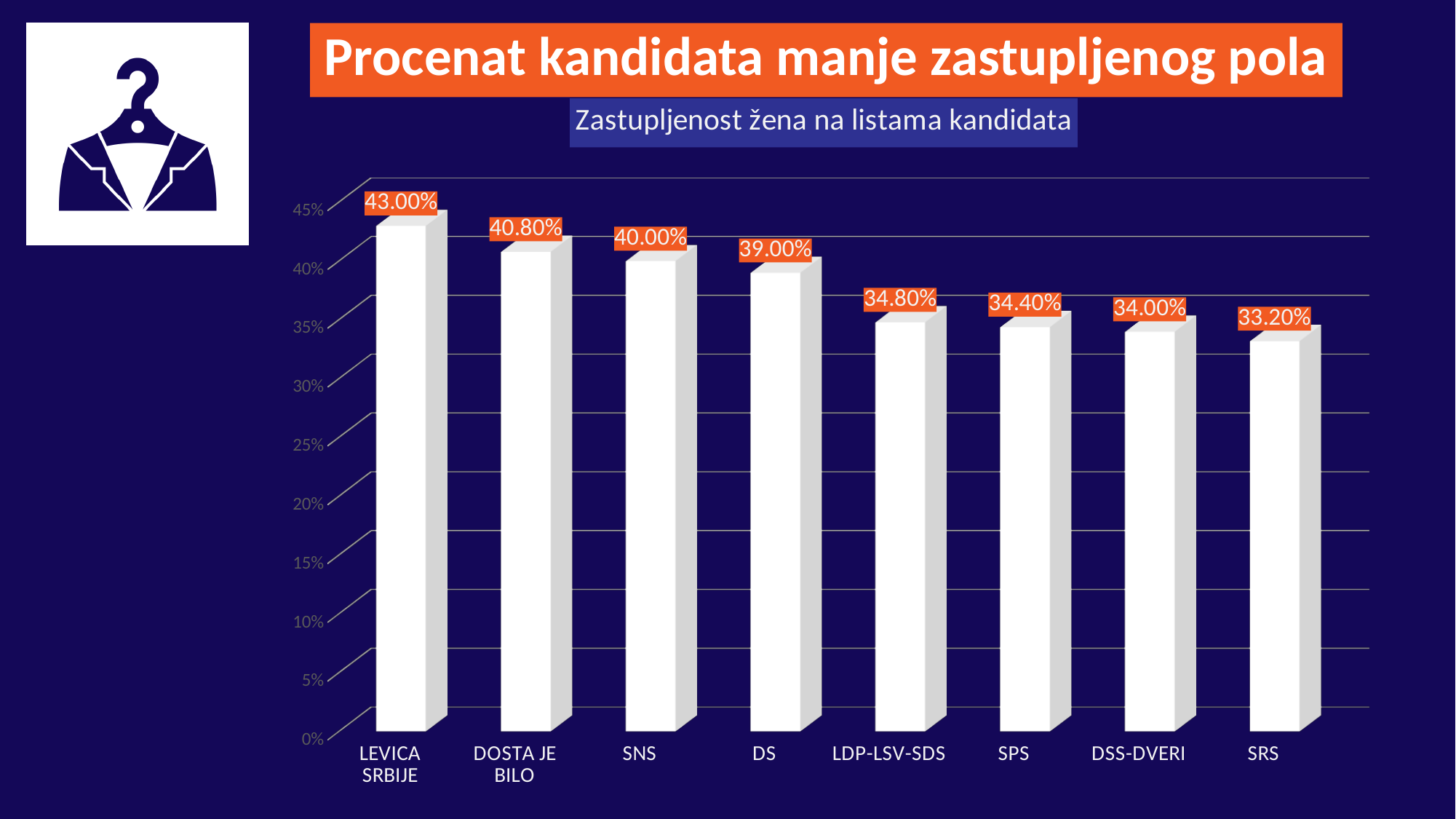
Which is larger, the value for DS or the value for SPS? DS Is the value for SPS greater or less than 30%? greater What is the value for LDP-LSV-SDS? 34.80% Which category has the highest value? LEVICA SRBIJE Do the values rise or fall from left to right along the x axis? fall What kind of chart is shown on the slide? bar chart How many categories are shown on the chart? 8 What is the difference between the values for DOSTA JE BILO and DS? 1.80% What is the difference between the values for LEVICA SRBIJE and SRS? 9.80% What is the value for SNS? 40.00% What is the value for DSS-DVERI? 34.00% Which category has the lowest value? SRS